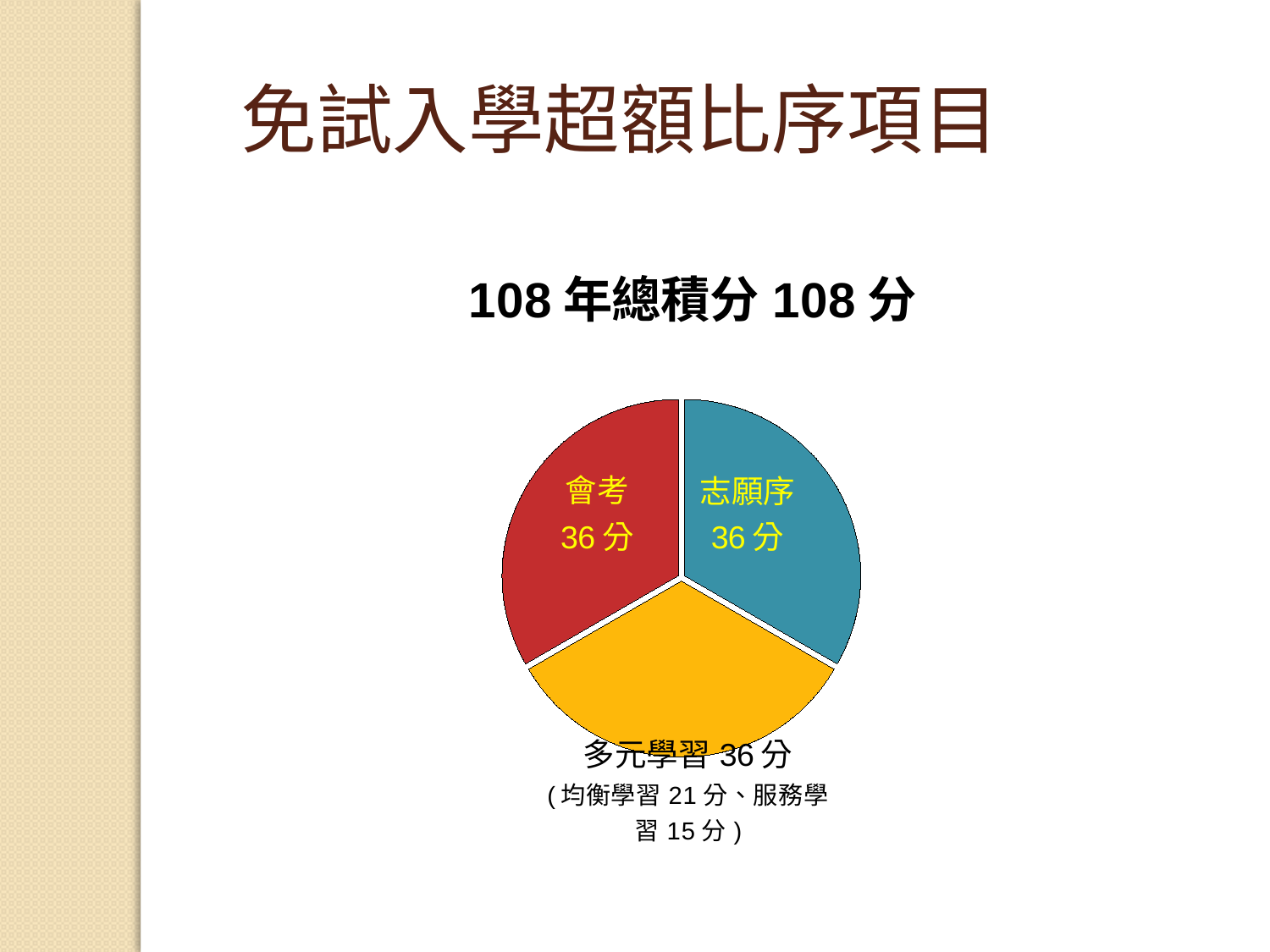
How many slices does the pie chart have? 3 What is the total of all slices in the pie chart? 108 分 What kind of chart is shown on the slide? pie chart What is the value of the 會考 slice? 36 分 What colour is the 會考 slice? red According to the 多元學習 label, how many points is 均衡學習 worth? 21 分 What is the value of the 多元學習 slice? 36 分 What is the value of the 志願序 slice? 36 分 What is the difference between the 會考 value and the 志願序 value? 0 分 What share of the pie does the 志願序 slice represent? 1/3 According to the 多元學習 label, how many points is 服務學習 worth? 15 分 What is the title of the pie chart? 108 年總積分 108 分